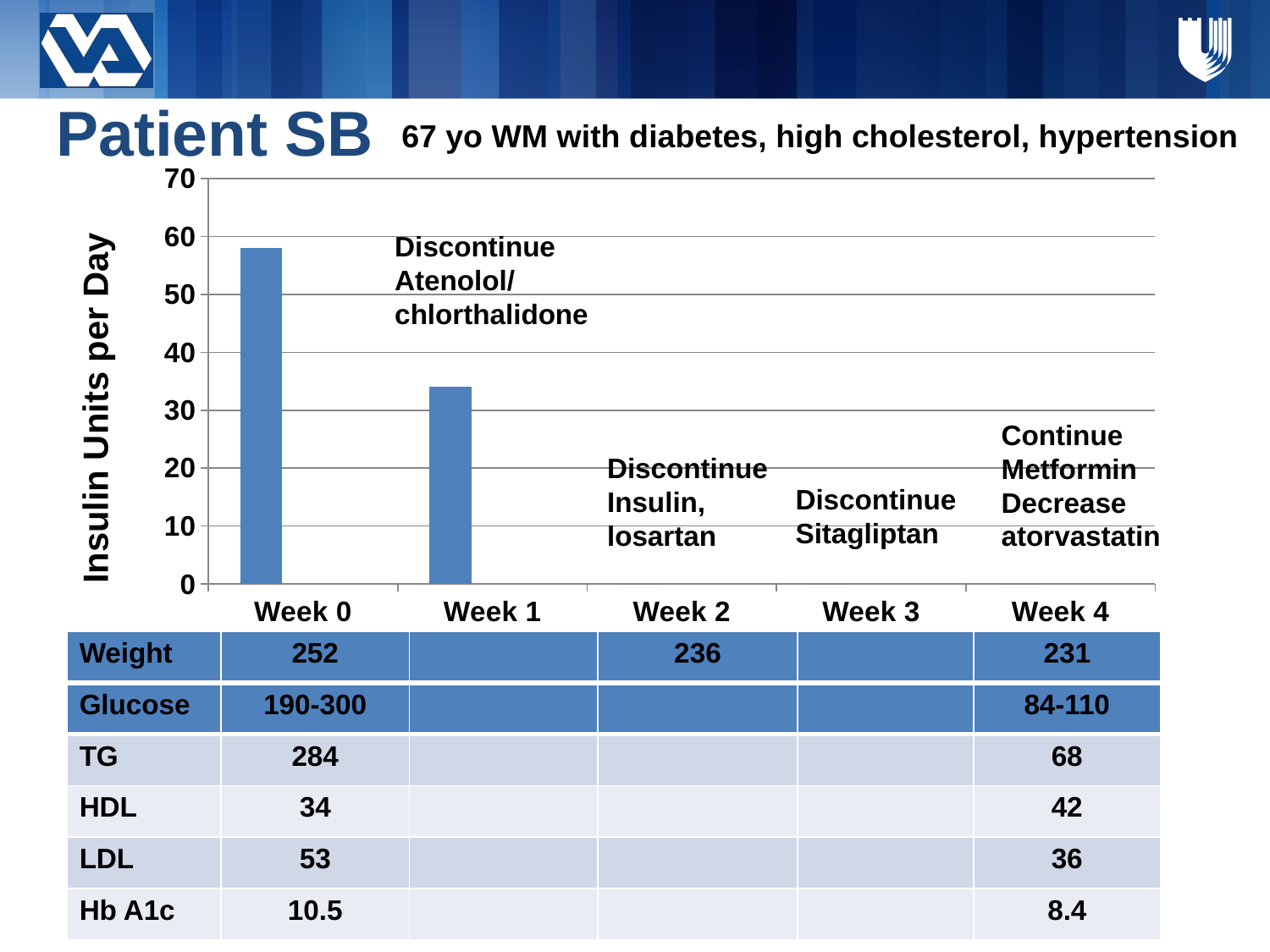
Is the insulin units per day value for Week 1 greater or less than 30? greater Is the insulin units per day value for Week 0 greater or less than 50? greater What kind of chart is shown on the slide? bar chart Which week has the highest insulin units per day in the chart? Week 0 What is the label on the y axis of the chart? Insulin Units per Day Is the insulin units per day value for Week 1 greater or less than 40? less Which is larger, the insulin units per day for Week 0 or for Week 1? Week 0 How many weeks in the chart show a visible bar for insulin units per day? 2 How many week categories are shown on the x axis of the chart? 5 Do the insulin units per day rise or fall from Week 0 to Week 1? fall What medication change is annotated on the chart near Week 1? Discontinue Atenolol/chlorthalidone